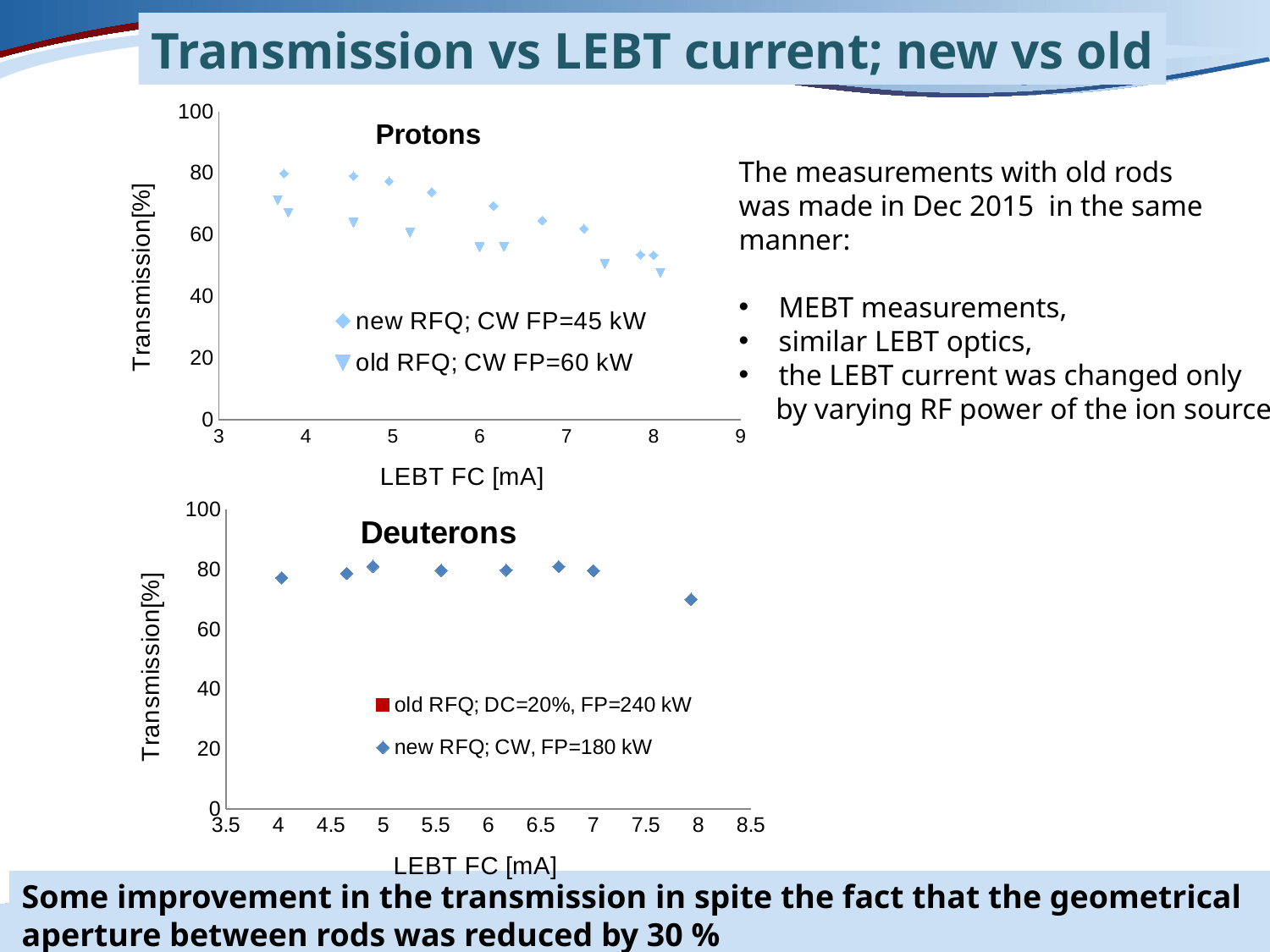
What kind of chart is the Protons chart? scatter chart How many series does the legend of the Deuterons chart list? 2 How many series does the legend of the Protons chart list? 2 In the Protons chart, is the old RFQ transmission at the lowest LEBT current (around 3.7 mA) greater or less than 60? greater In the Protons chart, does the transmission for the old RFQ series rise or fall as LEBT FC increases? fall In the Protons chart, does the transmission for the new RFQ series rise or fall as LEBT FC increases? fall What is the x-axis label of the Deuterons chart? LEBT FC [mA] What is the legend entry for the new RFQ series in the Deuterons chart? new RFQ; CW, FP=180 kW In the Deuterons chart, is the transmission at the highest LEBT current (around 8 mA) greater or less than 80? less How many data points are plotted in the Deuterons chart? 8 In the Protons chart, is the old RFQ transmission at the highest LEBT current (around 8 mA) greater or less than 60? less